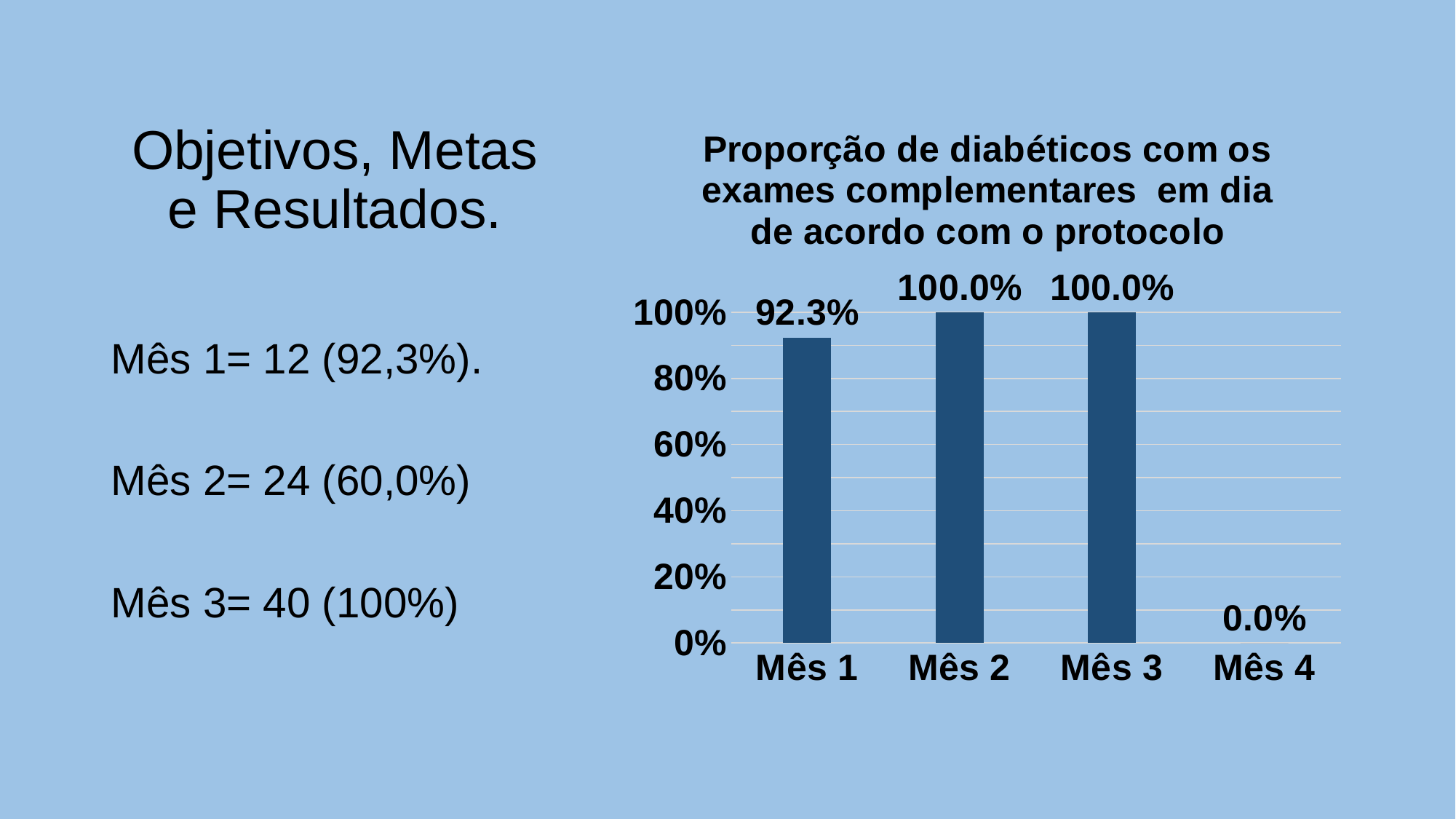
Which is larger, the value for Mês 1 or the value for Mês 3? Mês 3 Do the values for Mês 2 and Mês 3 have the same value? Yes How many categories are shown on the x axis? 4 What is the difference between the values for Mês 2 and Mês 1? 7.7% What is the highest tick value shown on the y axis? 100% What is the value for Mês 4? 0.0% Which category has the lowest value? Mês 4 What is the title of the chart? Proporção de diabéticos com os exames complementares em dia de acordo com o protocolo Is the value for Mês 1 greater or less than 80%? greater What is the value for Mês 1? 92.3% What kind of chart is shown? bar chart What is the value for Mês 2? 100.0%